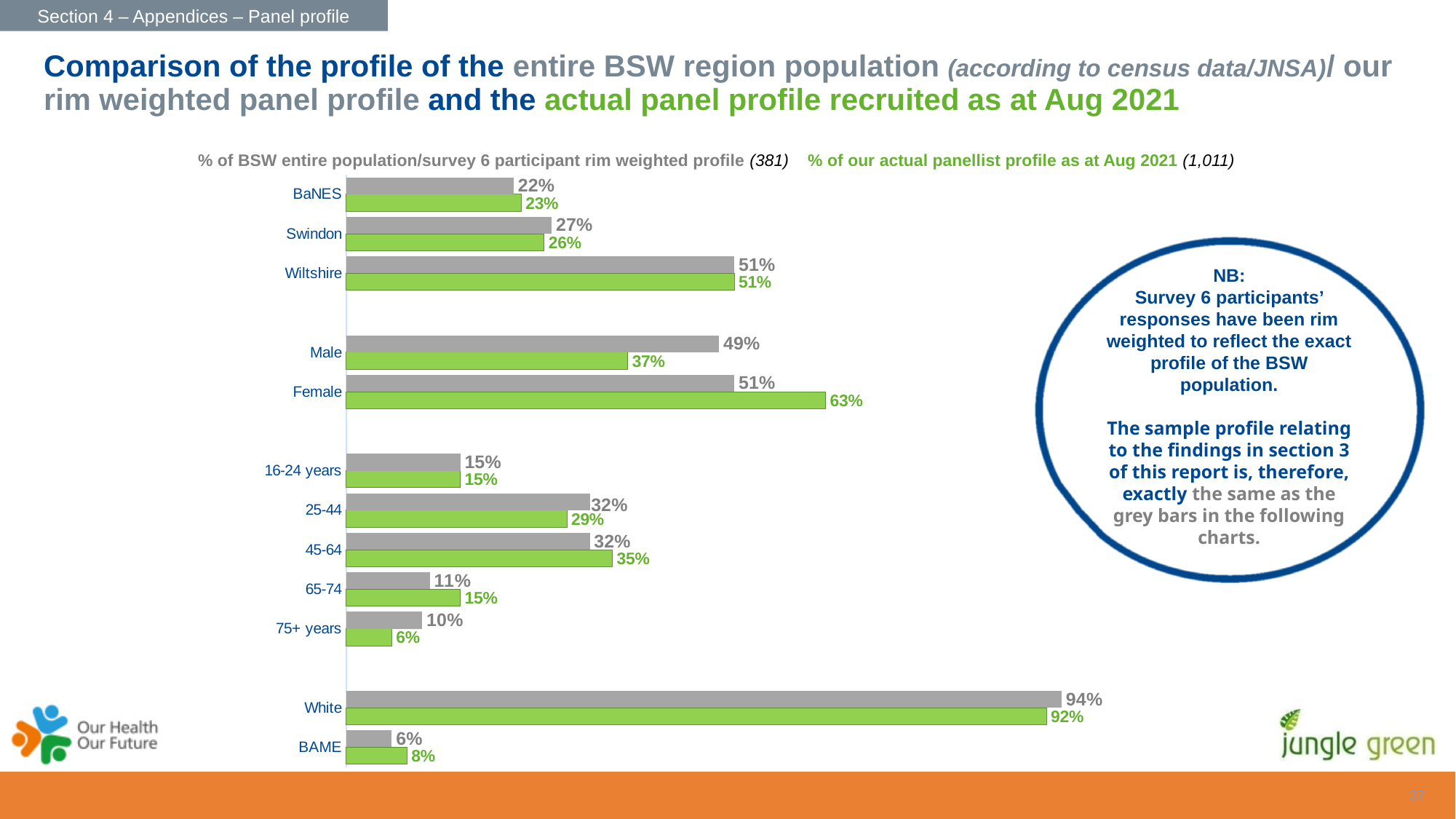
What kind of chart is shown on the slide? bar chart How many series does the chart legend list? 2 What is the difference between the grey and green values for Female? 12% What is the difference between the grey and green values for Male? 12% What is the value for Female in the '% of our actual panellist profile as at Aug 2021' series? 63% Which category has the highest value in the '% of BSW entire population/survey 6 participant rim weighted profile' series? White Which is larger for 45-64: the rim weighted profile value or the actual panellist profile value? the actual panellist profile value How many categories are shown on the chart? 12 What is the value for 65-74 in the '% of our actual panellist profile as at Aug 2021' series? 15% What is the value for Male in the '% of BSW entire population/survey 6 participant rim weighted profile' series? 49% What colour are the bars for the '% of our actual panellist profile as at Aug 2021' series? green Which category has the lowest value in the '% of our actual panellist profile as at Aug 2021' series? 75+ years